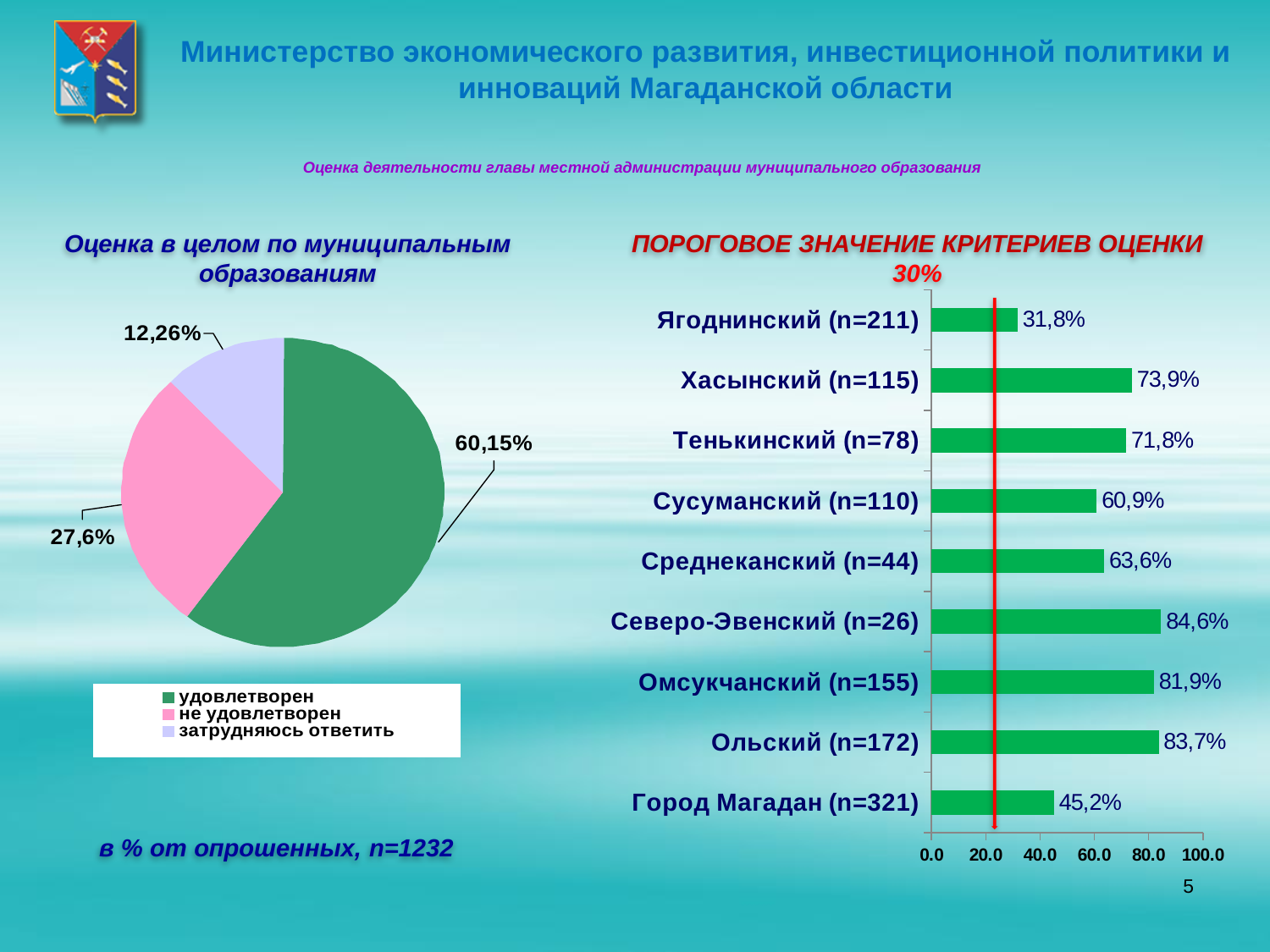
On the bar chart on the right, which category has the highest value? Северо-Эвенский (n=26) How many entries does the legend of the pie chart on the left list? 3 On the pie chart on the left, what is the value for 'затрудняюсь ответить'? 12,26% On the pie chart on the left, what is the difference between the 'удовлетворен' and 'не удовлетворен' slices? 32,55% On the bar chart on the right, what is the value for Город Магадан (n=321)? 45,2% On the bar chart on the right, which category has the lowest value? Ягоднинский (n=211) On the pie chart on the left, what share is labelled for 'удовлетворен'? 60,15% On the bar chart on the right, what is the difference between the values for Ольский (n=172) and Сусуманский (n=110)? 22,8% What kind of chart is the chart on the right of the slide? Bar chart On the bar chart on the right, what is the value for Хасынский (n=115)? 73,9% On the bar chart on the right, how many categories are shown? 9 On the bar chart on the right, which is larger: the value for Тенькинский (n=78) or Среднеканский (n=44)? Тенькинский (n=78)